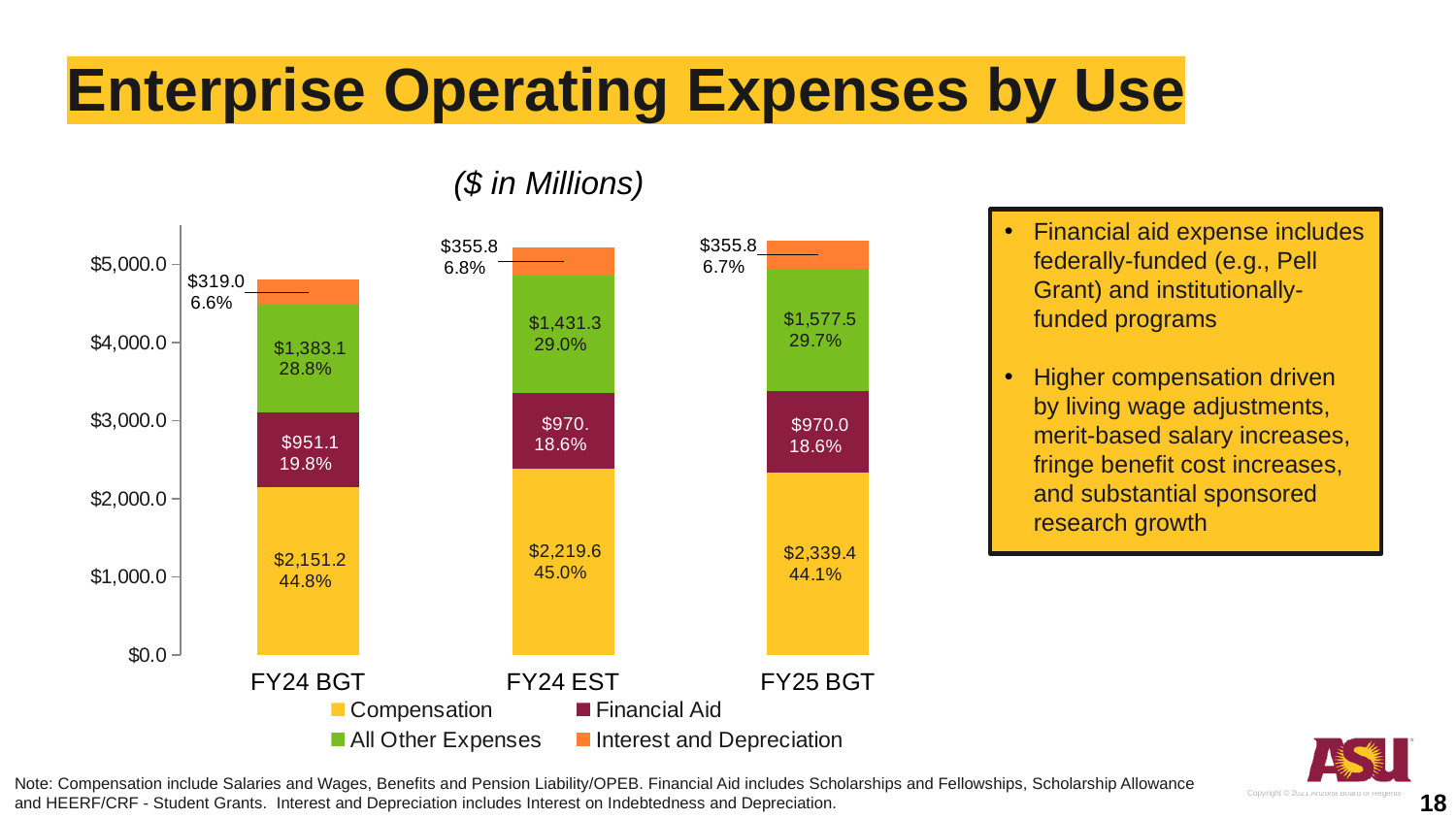
How many series does the legend list? 4 What is the Financial Aid value for FY24 BGT? $951.1 What percentage share does All Other Expenses represent in FY24 EST? 29.0% How many categories are shown on the x axis? 3 Is the total stacked bar for FY25 BGT greater or less than $5,000.0? greater What is the Compensation value for FY25 BGT? $2,339.4 Which is larger, All Other Expenses for FY25 BGT or for FY24 EST? FY25 BGT Which category has the highest Compensation value? FY25 BGT What is the Interest and Depreciation value for FY24 BGT? $319.0 What is the difference between the Compensation values for FY25 BGT and FY24 BGT? $188.2 What is the total of the stacked bar for FY25 BGT? $5,242.7 Which category has the lowest All Other Expenses value? FY24 BGT